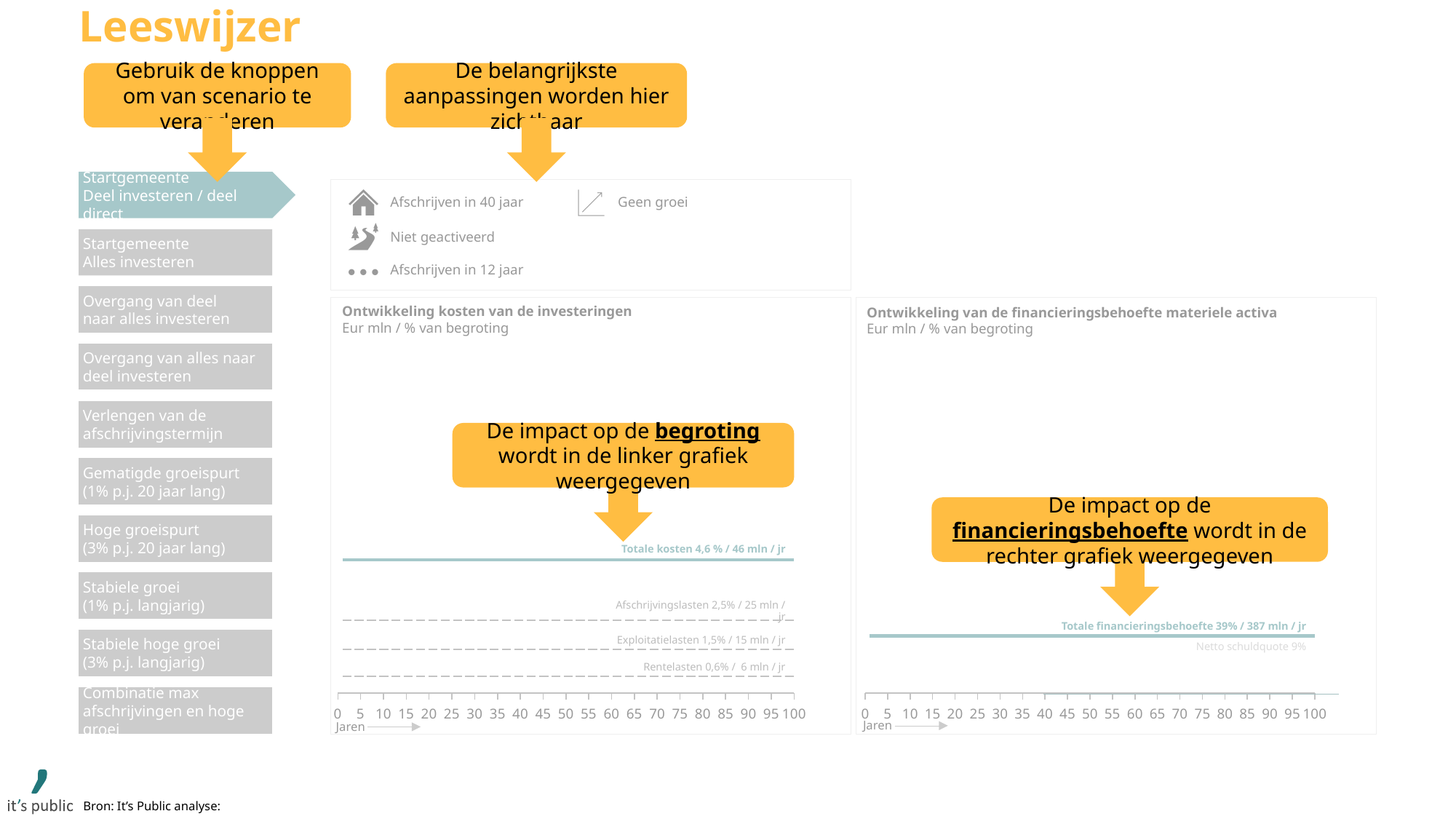
In the left chart, what is the difference in mln between Afschrijvingslasten and Exploitatielasten? 10 mln In the right chart, 'Ontwikkeling van de financieringsbehoefte materiele activa', what value is labelled for 'Totale financieringsbehoefte'? 39% / 387 mln / jr In the right chart, what value is labelled for 'Netto schuldquote'? 9% In the left chart, what value is labelled for 'Rentelasten'? 0,6% / 6 mln / jr In the left chart, which labelled line has the lowest value? Rentelasten What is the highest value shown on the x axis ('Jaren') of the left chart? 100 In the left chart, which is larger: Exploitatielasten or Rentelasten? Exploitatielasten In the right chart, does the 'Totale financieringsbehoefte' line rise, fall or stay flat along the x axis? stays flat What kind of chart is the left chart, 'Ontwikkeling kosten van de investeringen'? line chart In the left chart, what value is labelled for 'Totale kosten'? 4,6 % / 46 mln / jr In the left chart, what value is labelled for 'Afschrijvingslasten'? 2,5% / 25 mln / jr In the left chart, what value is labelled for 'Exploitatielasten'? 1,5% / 15 mln / jr